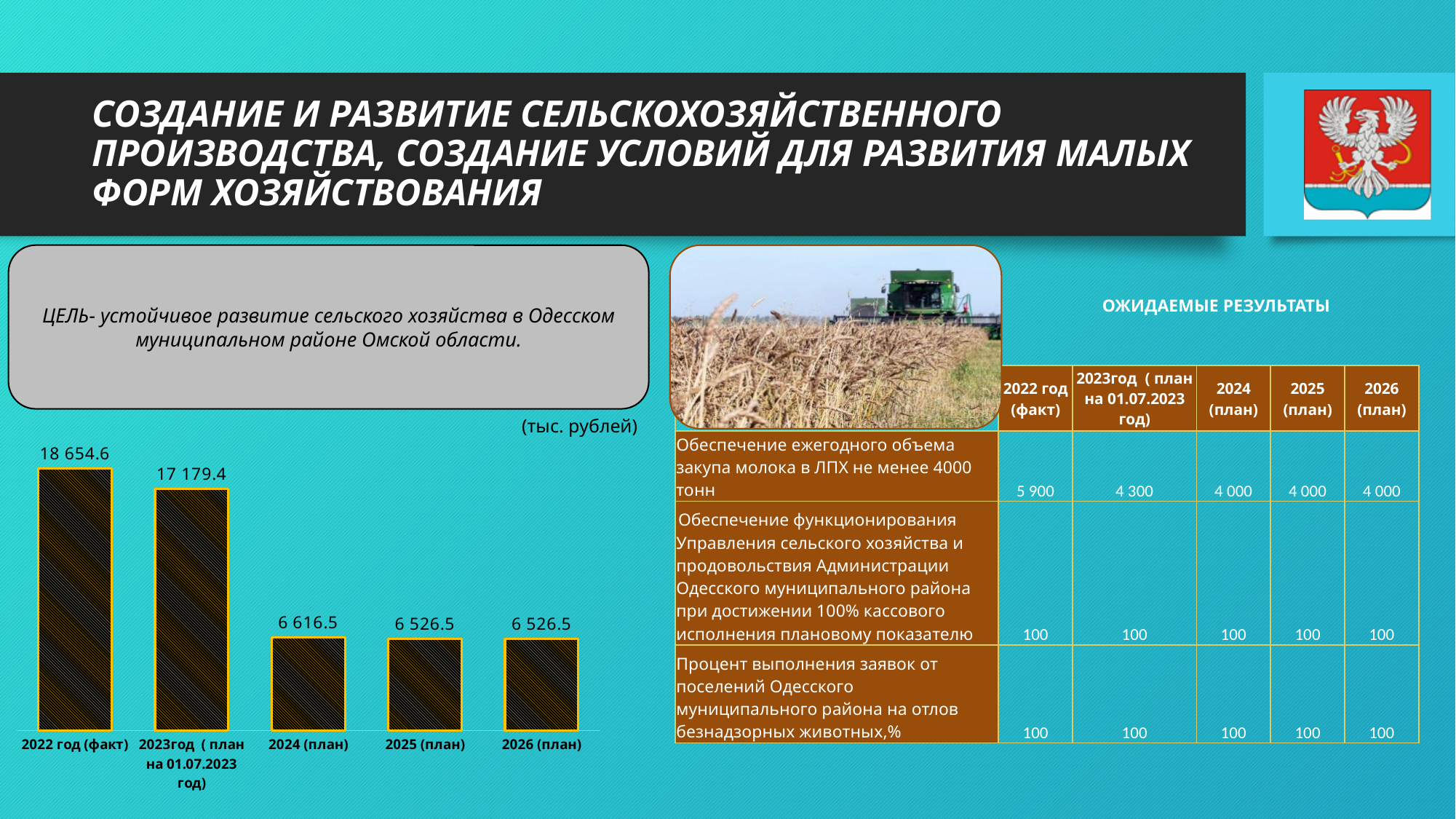
What is the difference between the values for 2022 год (факт) and 2023год (план на 01.07.2023 год) in the bar chart? 1 475.2 What is the value for 2024 (план) in the bar chart? 6 616.5 Do the values in the bar chart rise or fall from 2022 год (факт) to 2026 (план)? Fall What is the value for 2023год (план на 01.07.2023 год) in the bar chart? 17 179.4 What is the value for 2026 (план) in the bar chart? 6 526.5 Which is larger in the bar chart, the value for 2024 (план) or 2025 (план)? 2024 (план) How many categories are shown in the bar chart? 5 Which category has the highest value in the bar chart? 2022 год (факт) What kind of chart is shown on the left of the slide? Bar chart What unit is indicated above the bar chart? тыс. рублей What is the value for 2022 год (факт) in the bar chart? 18 654.6 What is the difference between the values for 2024 (план) and 2025 (план) in the bar chart? 90